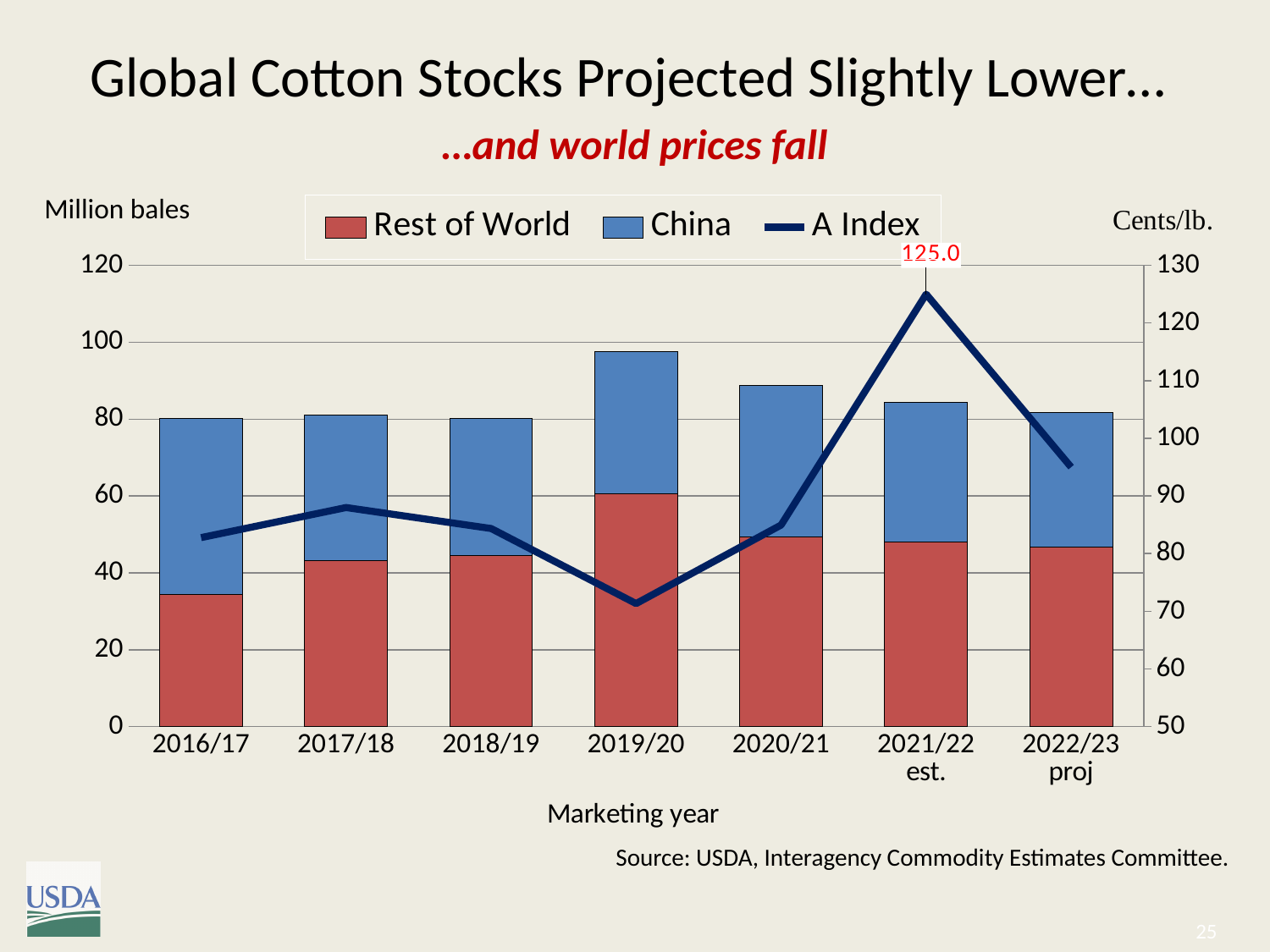
Is the total stacked bar for 2019/20 greater or less than 80 million bales? greater Which marketing year has the tallest total stacked bar? 2019/20 How many marketing years are shown on the x axis? 7 Which is larger, the total stacked bar for 2019/20 or for 2020/21? 2019/20 How many series does the legend list? 3 What unit is shown on the right-hand axis? Cents/lb. What kind of chart is this? Stacked bar chart with a line Does the A Index rise or fall from 2021/22 est. to 2022/23 proj? fall In which marketing year is the A Index lowest? 2019/20 In which marketing year is the A Index highest? 2021/22 est. Is the Rest of World value for 2016/17 greater or less than 40 million bales? less What is the A Index value shown for 2021/22 est.? 125.0